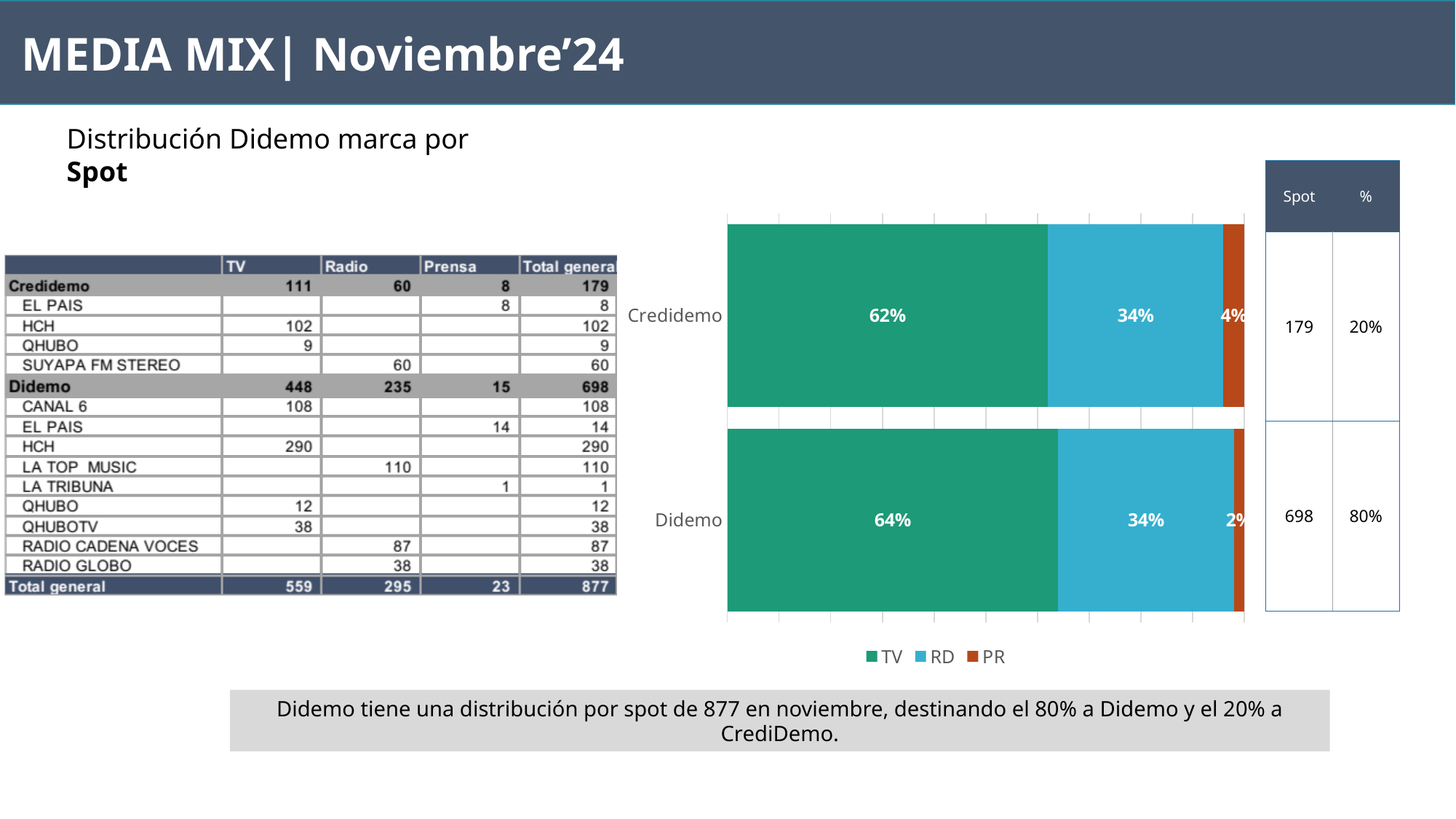
What is the RD share for Didemo in the chart? 34% How many categories are plotted in the chart? 2 Which series has the largest share in the Didemo bar? TV How many series does the chart legend list? 3 Which series has the smallest share in the Credidemo bar? PR What kind of chart is shown on the slide? stacked bar chart Which series is shown in orange in the chart legend? PR What is the difference between the TV share for Didemo and the TV share for Credidemo? 2% What is the TV share for Didemo in the chart? 64% What is the PR share for Didemo in the chart? 2% What is the TV share for Credidemo in the chart? 62% What is the PR share for Credidemo in the chart? 4%